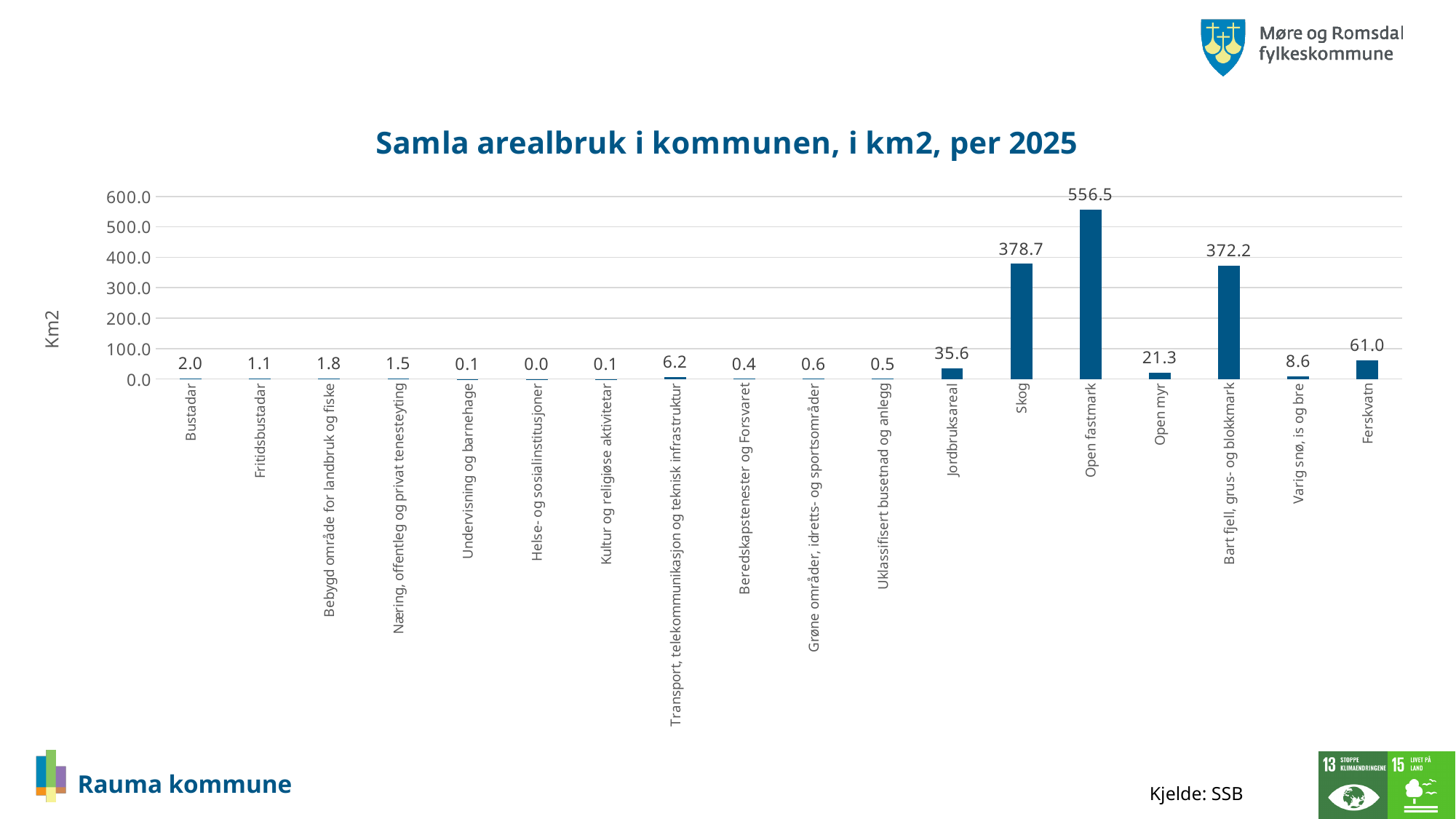
How many categories are shown on the x axis? 18 What is the difference between the values for Ferskvatn and Jordbruksareal? 25.4 What is the value for Skog? 378.7 Which is larger, the value for Skog or the value for Bart fjell, grus- og blokkmark? Skog Which category has the lowest value? Helse- og sosialinstitusjoner Is the value for Open fastmark greater or less than 500.0? greater What is the value for Ferskvatn? 61.0 Which category has the highest value? Open fastmark What is the difference between the values for Open fastmark and Skog? 177.8 What is the title of the chart? Samla arealbruk i kommunen, i km2, per 2025 What is the value for Open fastmark? 556.5 What is the value for Transport, telekommunikasjon og teknisk infrastruktur? 6.2